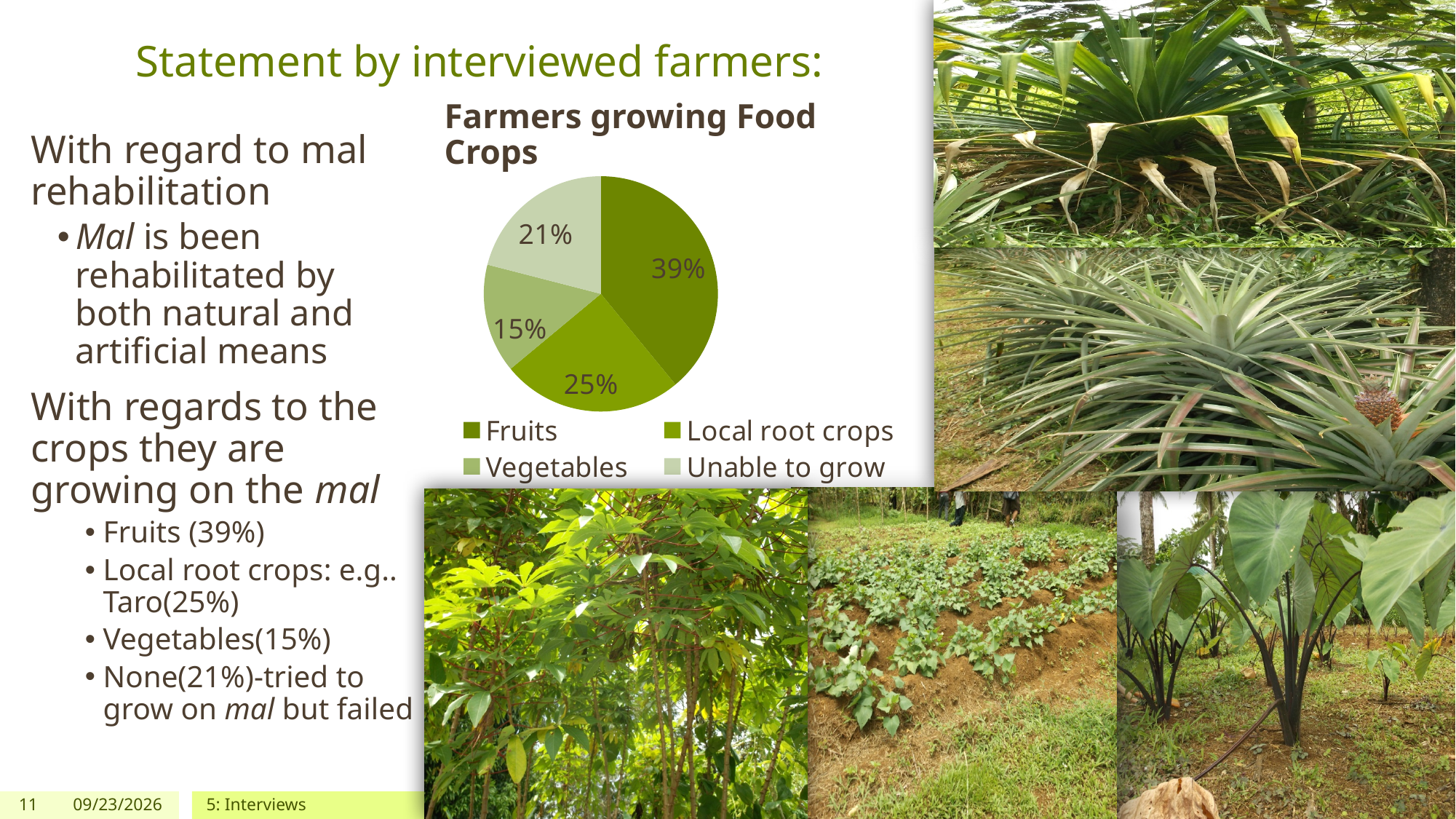
Which category has the smallest slice of the pie? Vegetables Which is larger, the Unable to grow slice or the Vegetables slice? Unable to grow What share of the pie is Fruits? 39% How many categories does the pie chart show? 4 What is the difference between the Fruits share and the Local root crops share? 14% What is the title of the chart? Farmers growing Food Crops Which category has the largest slice of the pie? Fruits What is the combined share of Fruits and Vegetables? 54% What kind of chart is shown on the slide? pie chart What share of the pie is Local root crops? 25% What share of the pie is Unable to grow? 21%